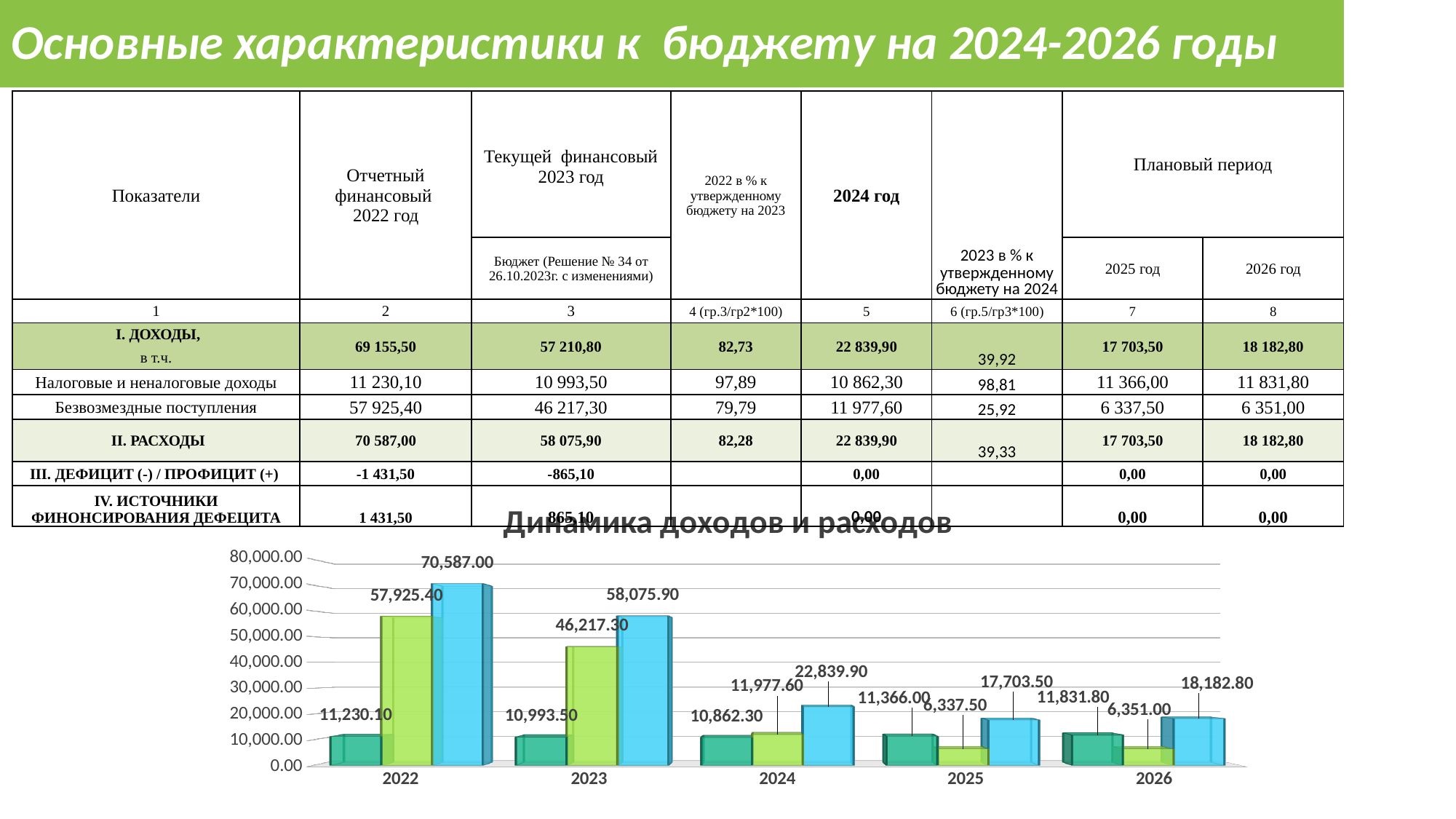
In the 'Динамика доходов и расходов' chart, do the blue bars rise or fall from 2022 to 2024? fall In the 'Динамика доходов и расходов' chart, what is the value of the dark green bar for 2026? 11,831.80 What is the title of the chart below the table? Динамика доходов и расходов What kind of chart is 'Динамика доходов и расходов'? bar chart In the 'Динамика доходов и расходов' chart, what is the lowest labelled value? 6,337.50 In the 'Динамика доходов и расходов' chart, what is the value of the blue bar for 2024? 22,839.90 In the 'Динамика доходов и расходов' chart, is the light green bar for 2025 greater or less than 10,000.00? less How many years are shown on the x axis of the 'Динамика доходов и расходов' chart? 5 In the 'Динамика доходов и расходов' chart, what is the value of the tallest (blue) bar for 2023? 58,075.90 In the 'Динамика доходов и расходов' chart, what is the difference between the blue bar for 2022 (70,587.00) and the blue bar for 2023 (58,075.90)? 12,511.10 In the 'Динамика доходов и расходов' chart, which year has the larger blue bar, 2025 or 2026? 2026 In the 'Динамика доходов и расходов' chart, what is the highest labelled value? 70,587.00